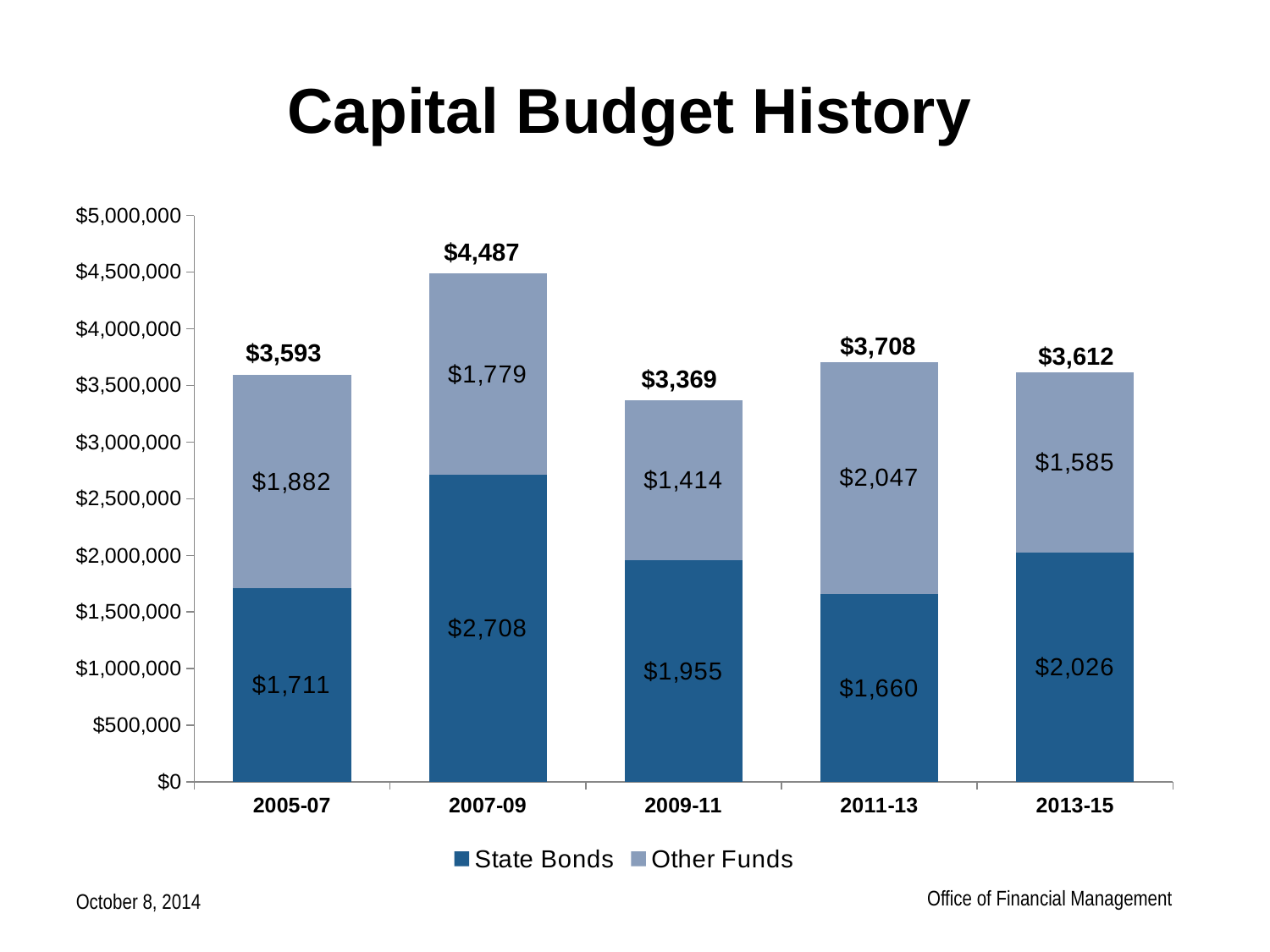
Which biennium has the highest total capital budget? 2007-09 Which series is shown in the darker blue colour? State Bonds Which is larger, the Other Funds value for 2005-07 or for 2013-15? 2005-07 What is the difference between the State Bonds values for 2013-15 and 2005-07? $315 Which biennium has the lowest State Bonds value? 2011-13 How many biennia are shown on the x axis? 5 What is the State Bonds value for 2007-09? $2,708 What is the Other Funds value for 2011-13? $2,047 How many series does the legend list? 2 What kind of chart is shown on the slide? Stacked bar chart What is the total shown above the bar for 2009-11? $3,369 What is the title of the chart? Capital Budget History